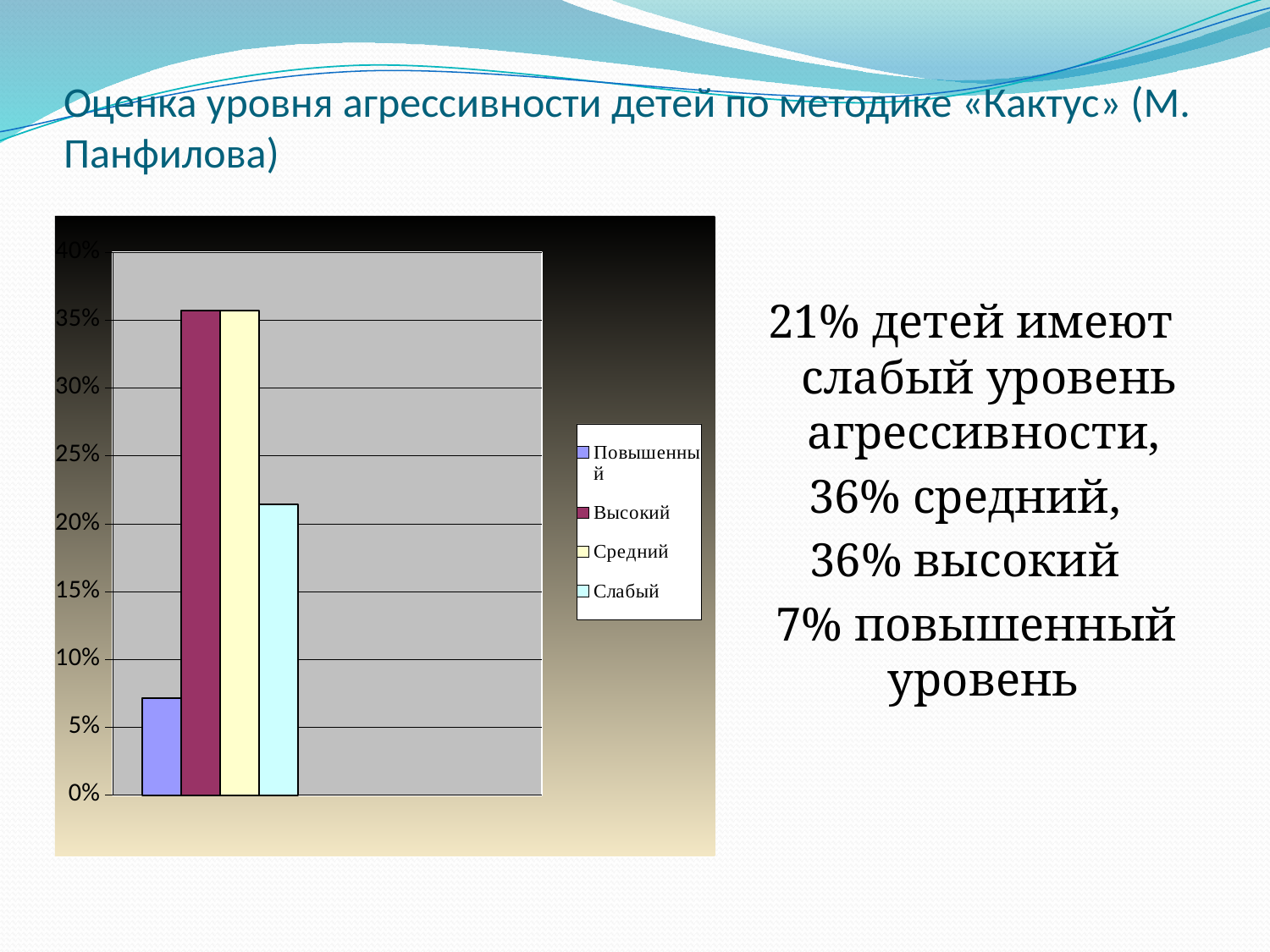
What kind of chart is shown on the slide? bar chart How many series does the chart legend list? 4 Is the value for Слабый greater or less than 25%? less Which bar is taller: Слабый or Повышенный? Слабый What are the four entries listed in the chart legend, from top to bottom? Повышенный, Высокий, Средний, Слабый Which bar is taller: Высокий or Слабый? Высокий Is the value for Повышенный greater or less than 10%? less How many bars are plotted in the chart? 4 Which series has the lowest bar in the chart? Повышенный According to the text on the slide, what percentage of children have a weak (слабый) level of aggressiveness? 21% Is the value for Высокий greater or less than 30%? greater